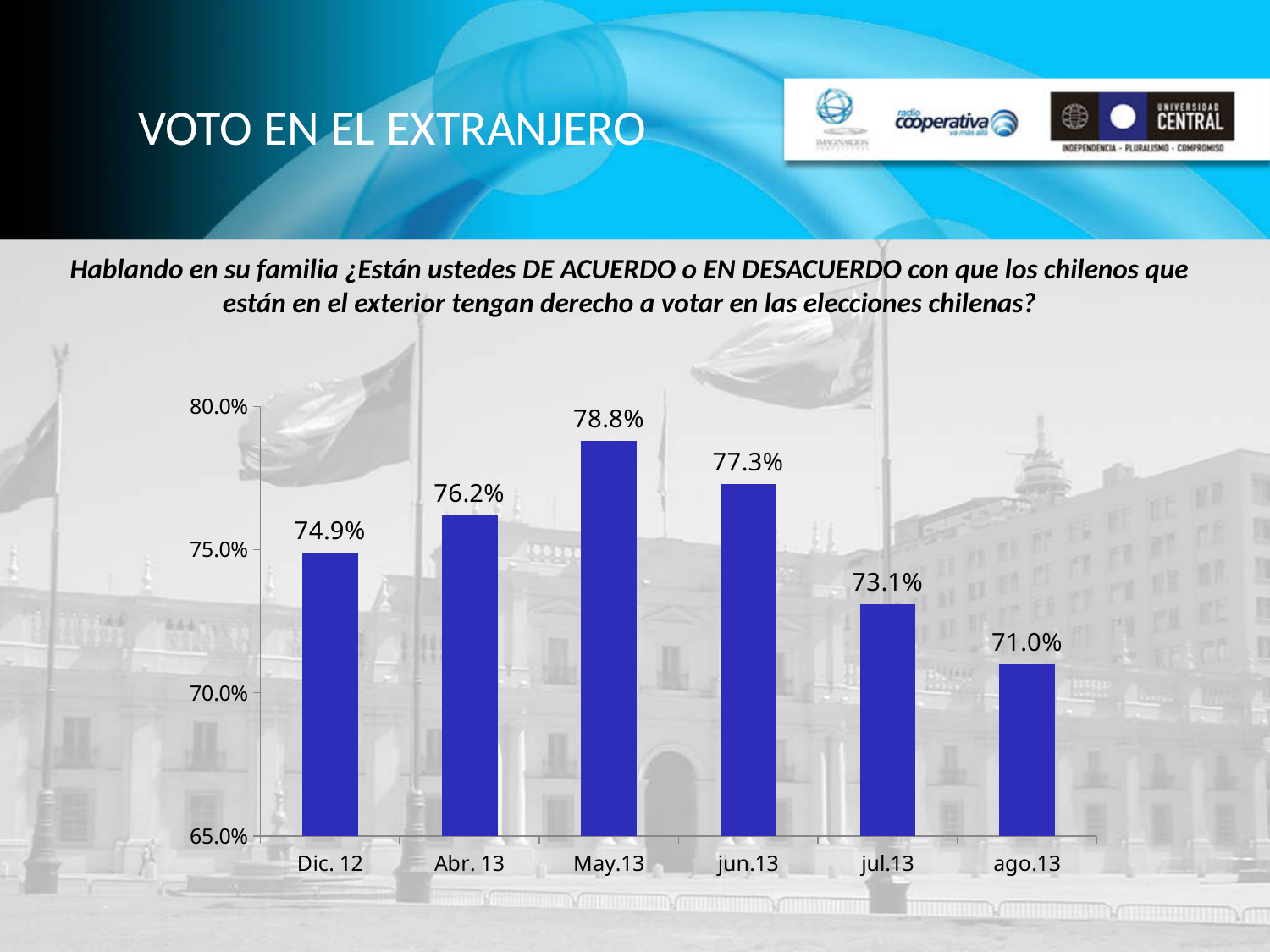
Which category has the highest value? May.13 What is the value for ago.13? 71.0% What is the value for Dic. 12? 74.9% What is the value for May.13? 78.8% Do the values rise or fall from May.13 to ago.13? fall How many categories are shown on the x axis? 6 Which category has the lowest value? ago.13 What is the difference between the values for Abr. 13 and Dic. 12? 1.3% Is the value for jul.13 greater or less than 75.0%? less What kind of chart is shown on the slide? bar chart What is the difference between the values for May.13 and ago.13? 7.8% Which is larger, the value for jun.13 or the value for jul.13? jun.13